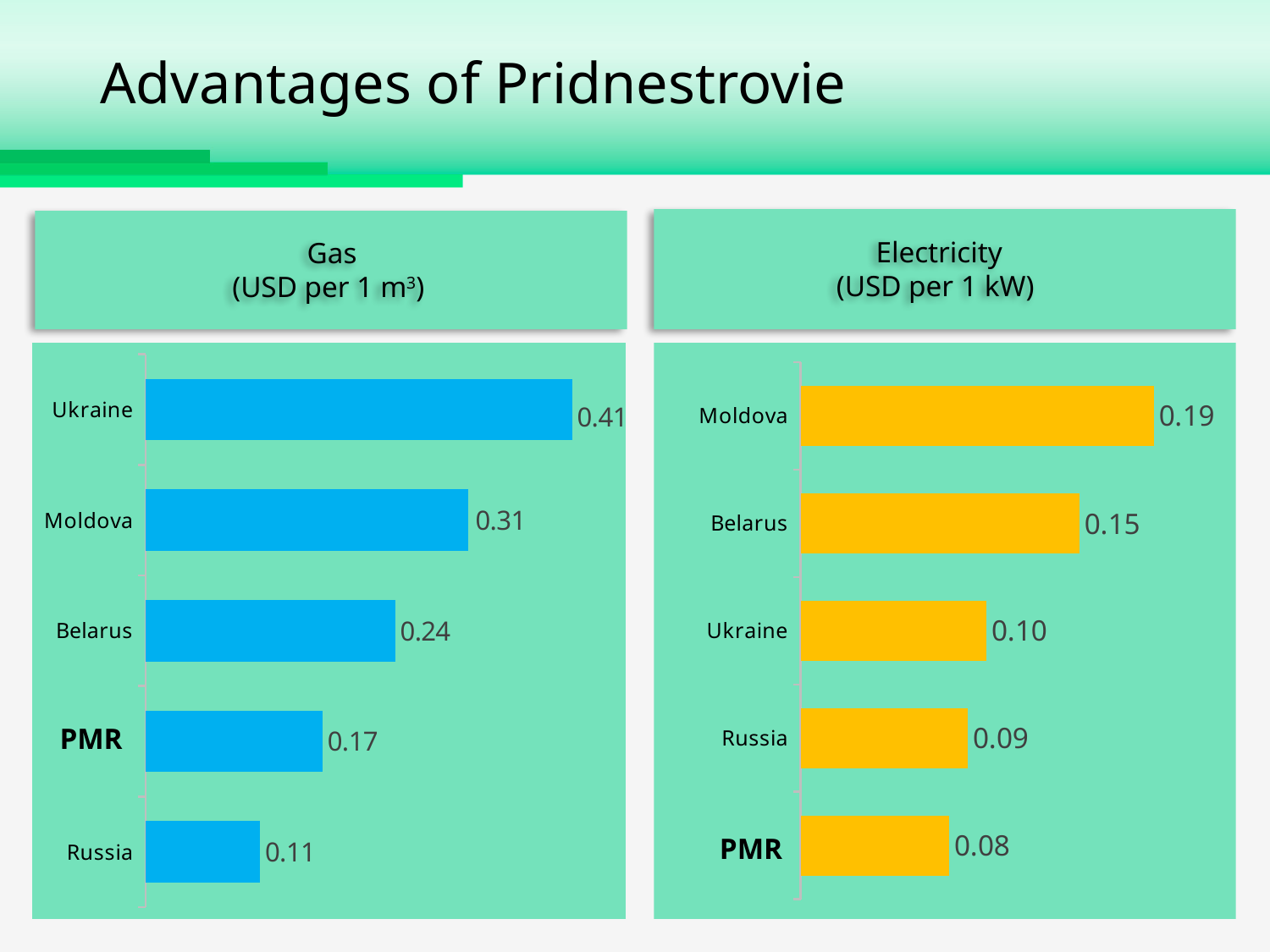
In the Gas chart, what is the difference between the values for Ukraine and PMR? 0.24 In the Gas chart, what is the value for Ukraine? 0.41 What kind of chart is the Gas chart? Bar chart In the Electricity chart, what is the value for PMR? 0.08 In the Electricity chart, which category has the lowest value? PMR In the Electricity chart, which is larger, the value for Moldova or the value for Ukraine? Moldova In the Electricity chart, which category has the highest value? Moldova How many categories are shown in the Electricity chart? 5 In the Electricity chart, what is the value for Belarus? 0.15 In the Gas chart, what is the value for PMR? 0.17 In the Gas chart, which category has the lowest value? Russia In the Gas chart, which category has the highest value? Ukraine